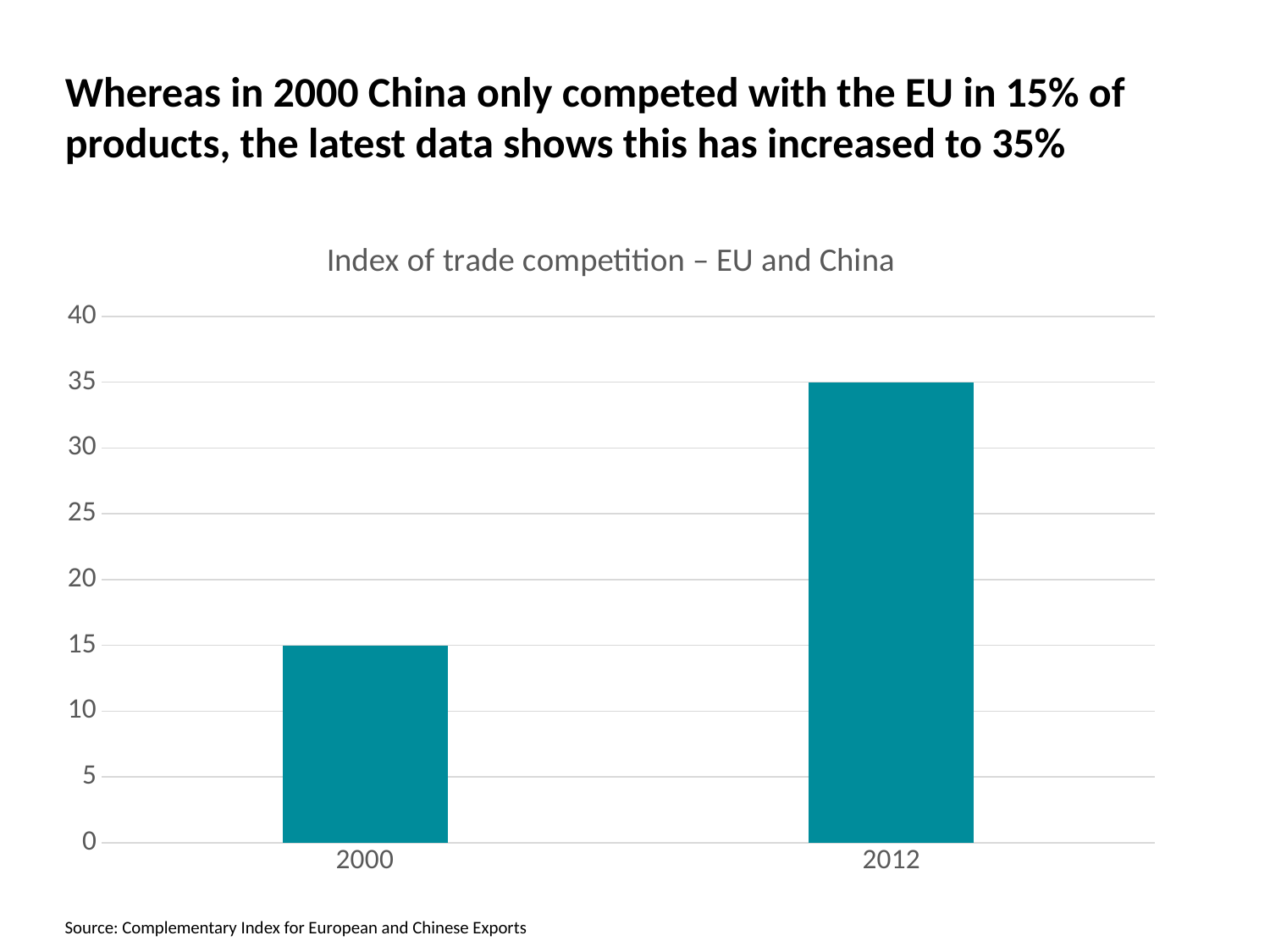
What is the title of the chart? Index of trade competition – EU and China By how much did the index of trade competition increase from 2000 to 2012? 20 Is the value for 2012 greater or less than 30? greater Is the value for 2000 greater or less than 20? less What kind of chart is shown on the slide? bar chart Which year has the higher index of trade competition? 2012 What is the value of the index of trade competition for 2000? 15 Is the value for 2012 larger or smaller than the value for 2000? larger Which year has the lower index of trade competition? 2000 What is the value of the index of trade competition for 2012? 35 Does the index of trade competition rise or fall from 2000 to 2012? rise How many years are shown on the x axis of the chart? 2